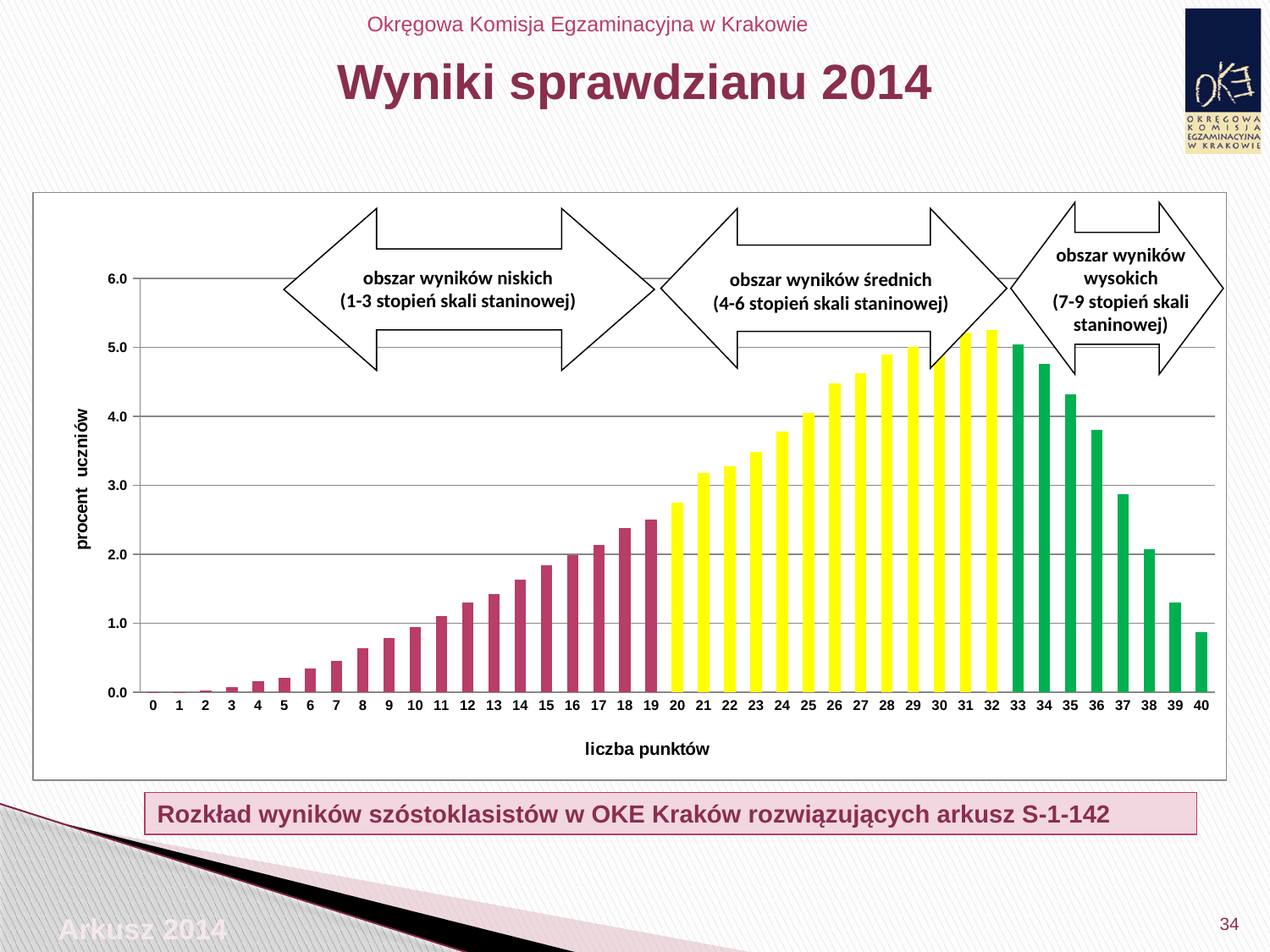
Is the value for 36 points greater or less than 4.0? less Is the value for 40 points greater or less than 1.0? less Which has a larger value, 35 points or 36 points? 35 points How many score categories (liczba punktów) are shown on the x axis? 41 Is the value for 20 points greater or less than 3.0? less What is the title of the x axis? liczba punktów Do the values rise or fall from 0 points to 19 points? rise Which has a larger value, 32 points or 40 points? 32 points Do the values rise or fall from 33 points to 40 points? fall What kind of chart is shown on the slide? bar chart